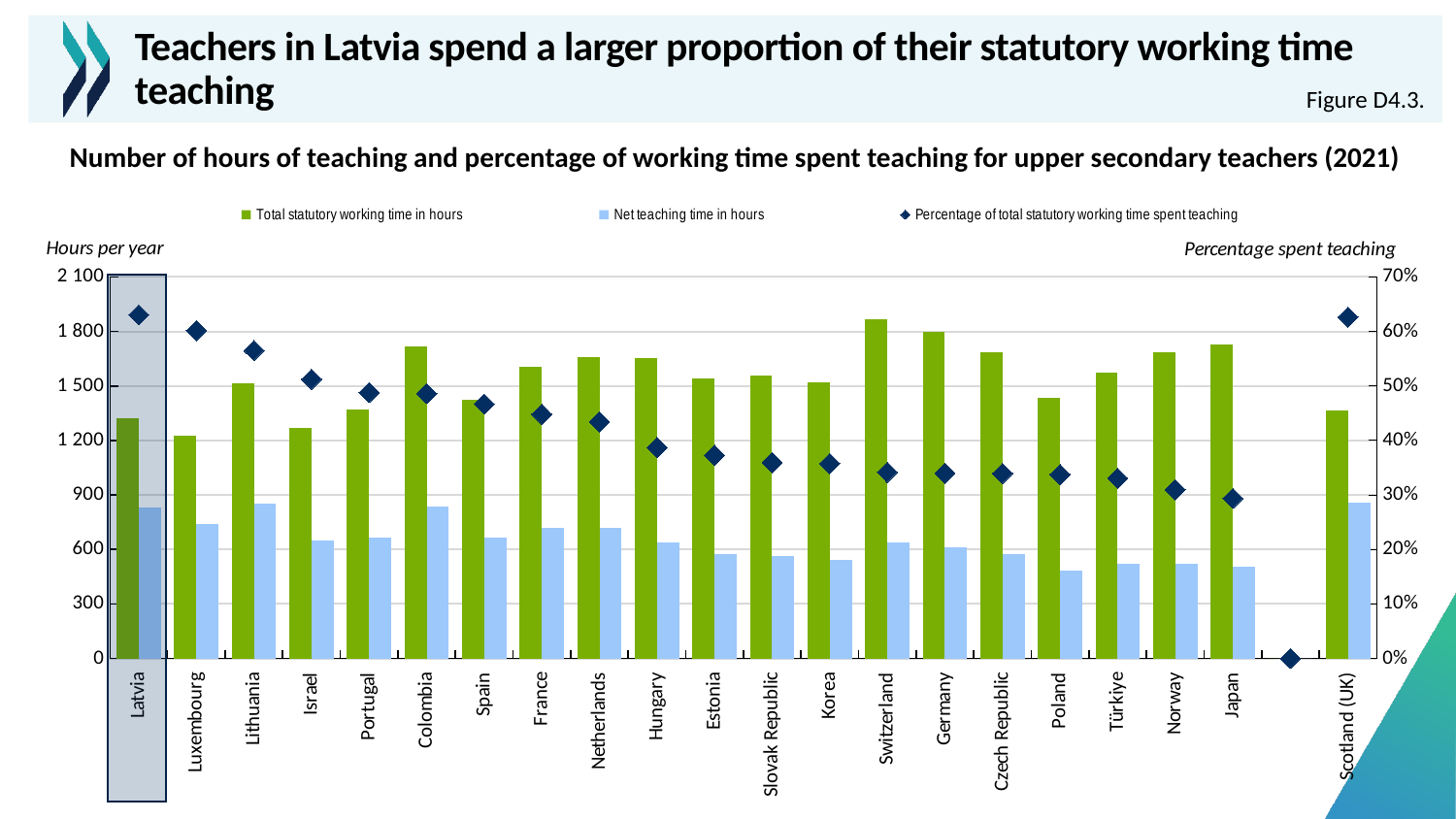
Which country has the lowest total statutory working time in hours? Luxembourg Is the percentage of total statutory working time spent teaching for Latvia greater or less than 60%? greater What kind of chart is used to show the hours of teaching? bar chart Do the percentages of working time spent teaching rise or fall along the x axis from Latvia to Japan? fall Is the total statutory working time for Switzerland greater or less than 1 800 hours? greater Which country has the highest total statutory working time in hours? Switzerland Is the net teaching time for Poland greater or less than 600 hours? less What is the label of the right-hand vertical axis? Percentage spent teaching Which has the larger percentage of statutory working time spent teaching, Latvia or Japan? Latvia How many series does the chart legend list? 3